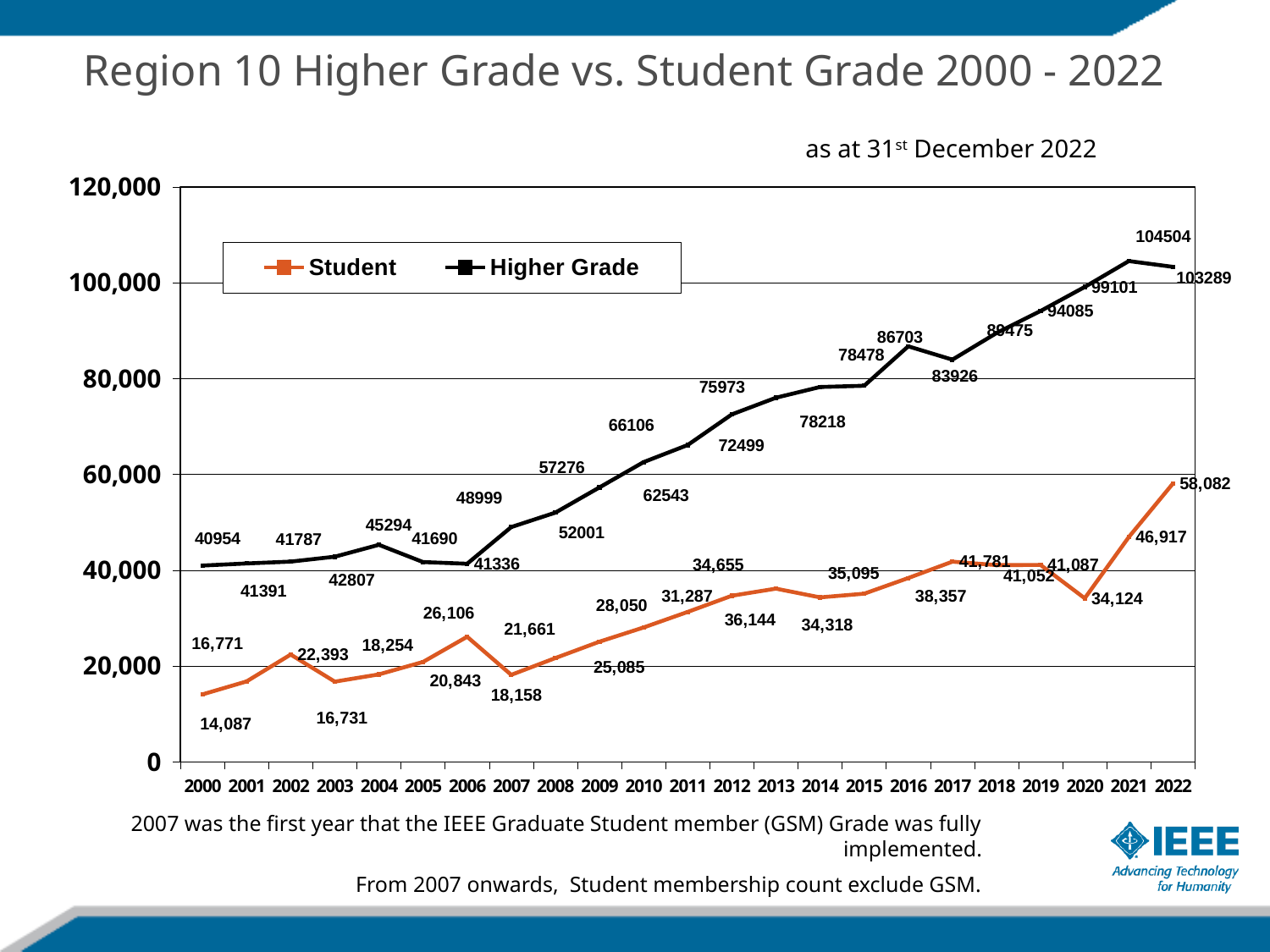
What is the Higher Grade value for 2022? 103289 What is the Student value for 2022? 58,082 What kind of chart is shown on the slide? line chart In which year is the Student series at its lowest? 2000 What is the Student value for 2007? 18,158 Which year has the larger Student value, 2019 or 2020? 2019 By how much did the Higher Grade value fall from 2021 to 2022? 1215 Is the Higher Grade value for 2010 greater or less than 60,000? greater How many years are plotted on the x axis? 23 Does the Higher Grade series generally rise or fall from 2007 to 2021? rise How many series does the legend list? 2 In which year is the Higher Grade series at its highest? 2021